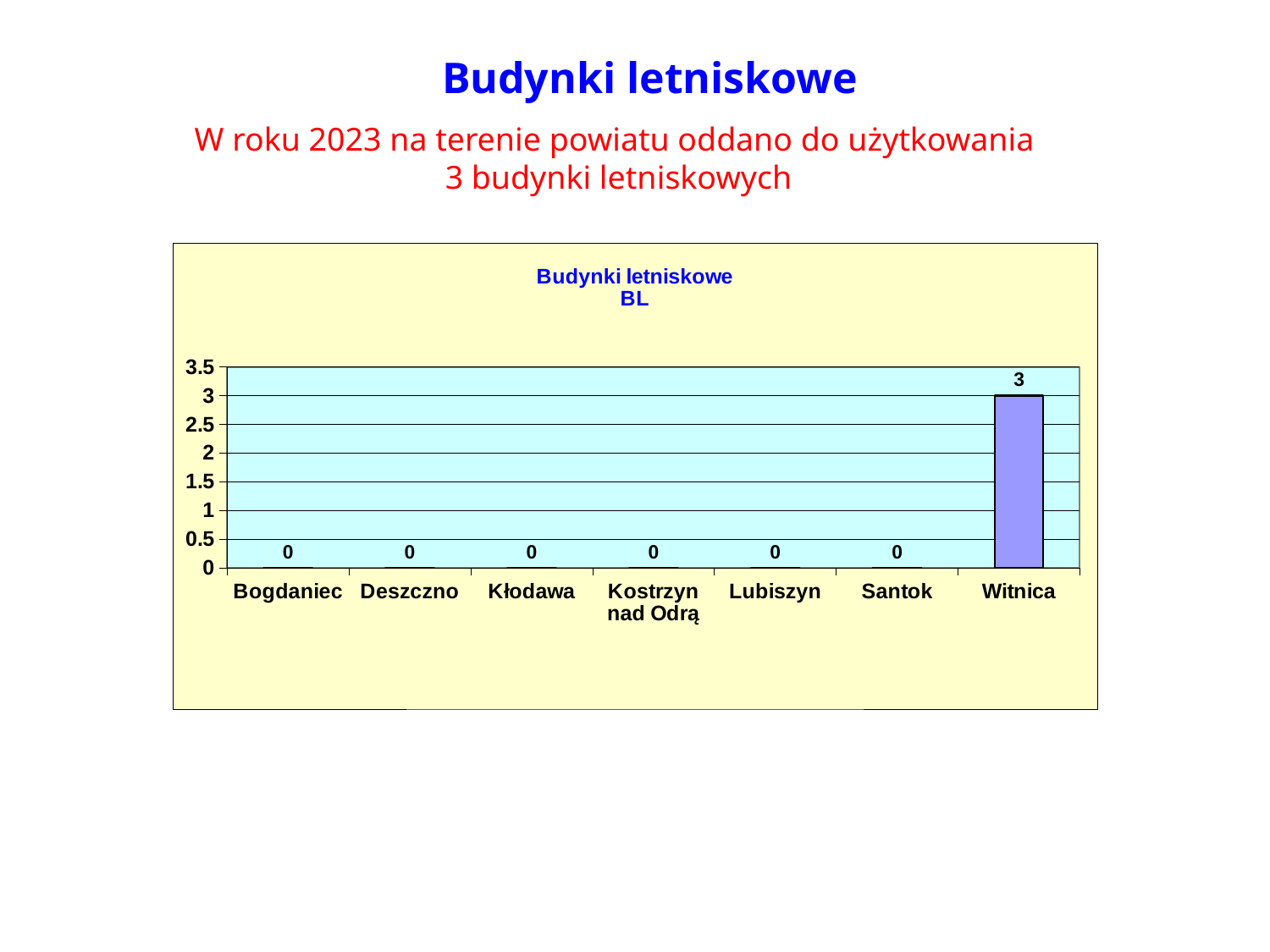
How many categories are shown on the x axis? 7 What is the value for Bogdaniec? 0 What is the value for Kostrzyn nad Odrą? 0 What is the total of all the values shown in the chart? 3 Which category has the highest value? Witnica Is the value for Witnica greater or less than 2? greater What is the value for Witnica? 3 What kind of chart is shown? bar chart What is the difference between the values for Witnica and Santok? 3 What is the title of the chart? Budynki letniskowe BL Which is larger, the value for Witnica or the value for Lubiszyn? Witnica How many categories have a value of 0? 6